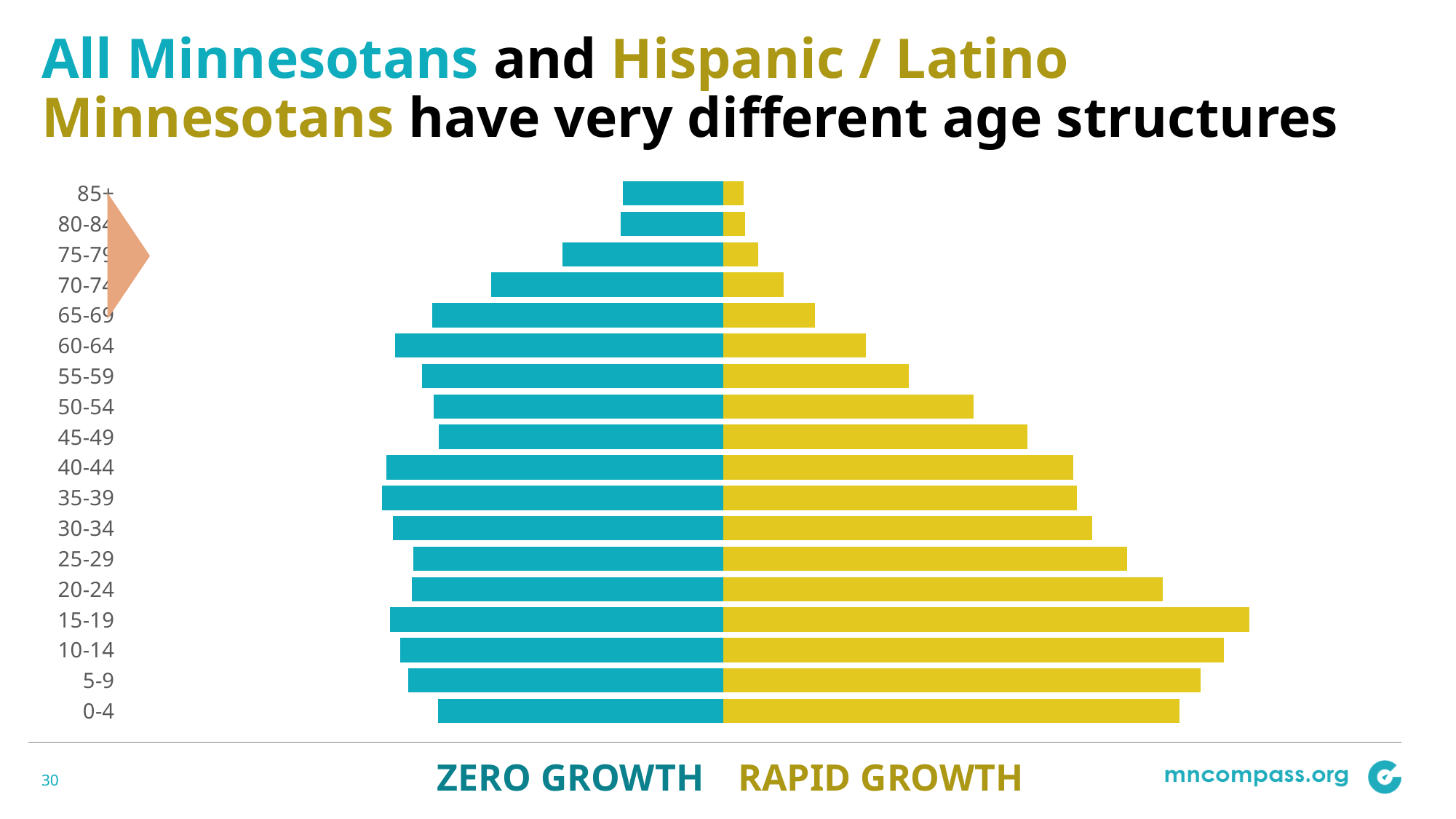
Do the Hispanic / Latino Minnesotans bars generally get longer or shorter as the age groups get older? shorter Which colour represents All Minnesotans on the chart? teal For Hispanic / Latino Minnesotans, is the bar for 15-19 longer or shorter than the bar for 0-4? longer How many age groups are shown on the chart? 18 What kind of chart is shown on the slide? bar chart For All Minnesotans, which bar is longer: 60-64 or 75-79? 60-64 For the 85+ age group, which series has the longer bar: All Minnesotans or Hispanic / Latino Minnesotans? All Minnesotans Which age group has the longest bar for Hispanic / Latino Minnesotans? 15-19 What label appears beneath the Hispanic / Latino Minnesotans side of the chart? RAPID GROWTH How many population groups (series) does the chart compare? 2